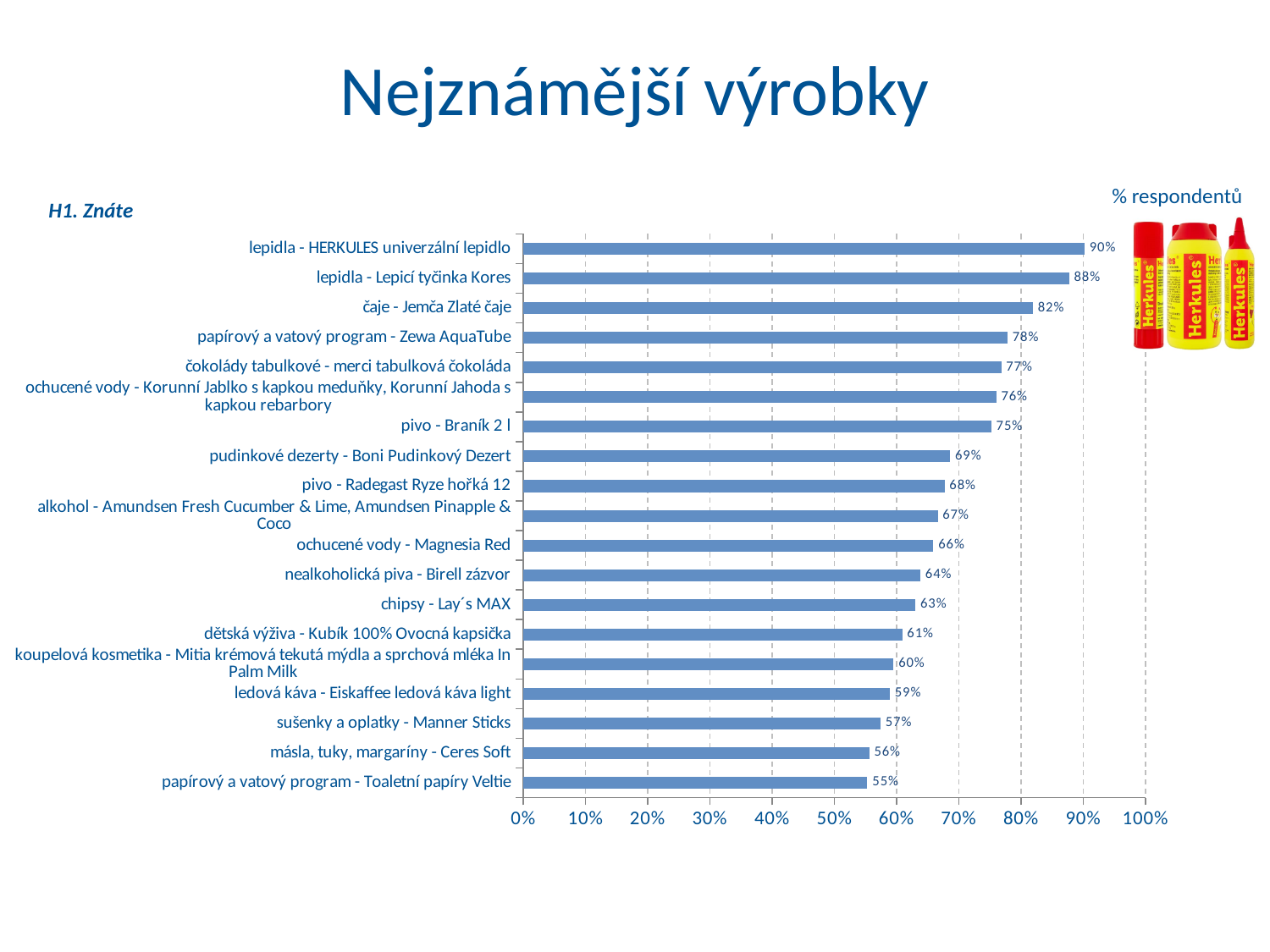
What is the value for chipsy - Lay´s MAX? 63% Which has a higher value: pudinkové dezerty - Boni Pudinkový Dezert or nealkoholická piva - Birell zázvor? pudinkové dezerty - Boni Pudinkový Dezert What is the title of the slide? Nejznámější výrobky Which product has the highest percentage of respondents? lepidla - HERKULES univerzální lepidlo What kind of chart is shown on the slide? bar chart What is the value for papírový a vatový program - Zewa AquaTube? 78% What is the value for pivo - Braník 2 l? 75% How many products are shown in the chart? 19 Is the value for sušenky a oplatky - Manner Sticks greater or less than 60%? less What is the difference between the values for lepidla - Lepicí tyčinka Kores and čaje - Jemča Zlaté čaje? 6% What percentage of respondents know lepidla - HERKULES univerzální lepidlo? 90% Which product has the lowest percentage of respondents? papírový a vatový program - Toaletní papíry Veltie